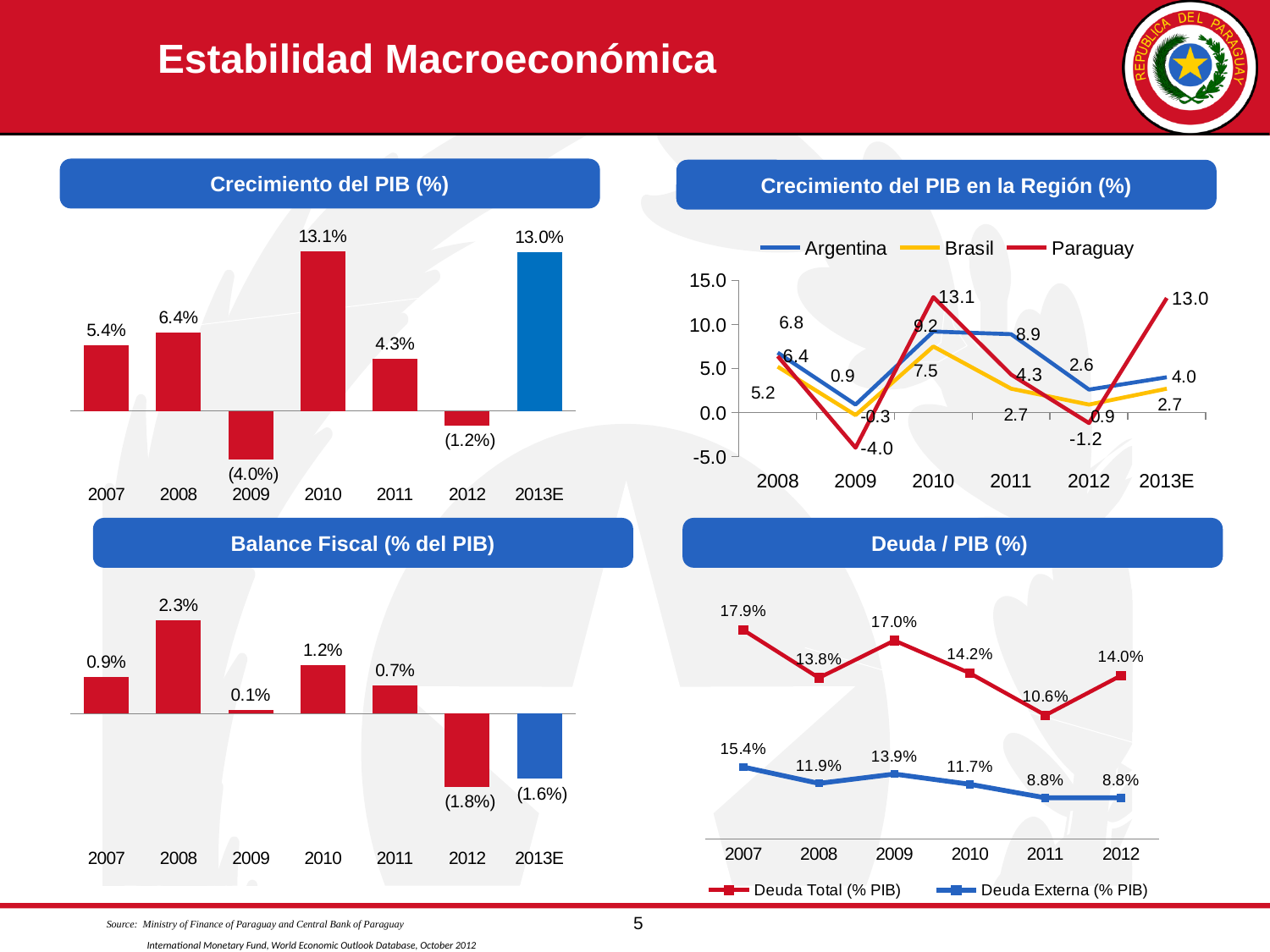
In the 'Crecimiento del PIB (%)' chart, what is the value for 2010? 13.1% In the 'Crecimiento del PIB (%)' chart, which year has the lowest value? 2009 In the 'Deuda / PIB (%)' chart, what is the difference between Deuda Total (% PIB) and Deuda Externa (% PIB) in 2012? 5.2% In the 'Crecimiento del PIB (%)' chart, how many years are shown on the x axis? 7 In the 'Balance Fiscal (% del PIB)' chart, which is larger, the value for 2010 or the value for 2011? 2010 In the 'Crecimiento del PIB (%)' chart, what is the difference between the 2008 and 2007 values? 1.0% In the 'Crecimiento del PIB en la Región (%)' chart, which country has the highest value in 2013E? Paraguay In the 'Crecimiento del PIB en la Región (%)' chart, how many series does the legend list? 3 In the 'Crecimiento del PIB en la Región (%)' chart, what is the value for Argentina in 2013E? 4.0 What kind of chart is 'Crecimiento del PIB en la Región (%)'? line chart In the 'Balance Fiscal (% del PIB)' chart, what is the value for 2008? 2.3% In the 'Deuda / PIB (%)' chart, what is the value of Deuda Total (% PIB) in 2011? 10.6%